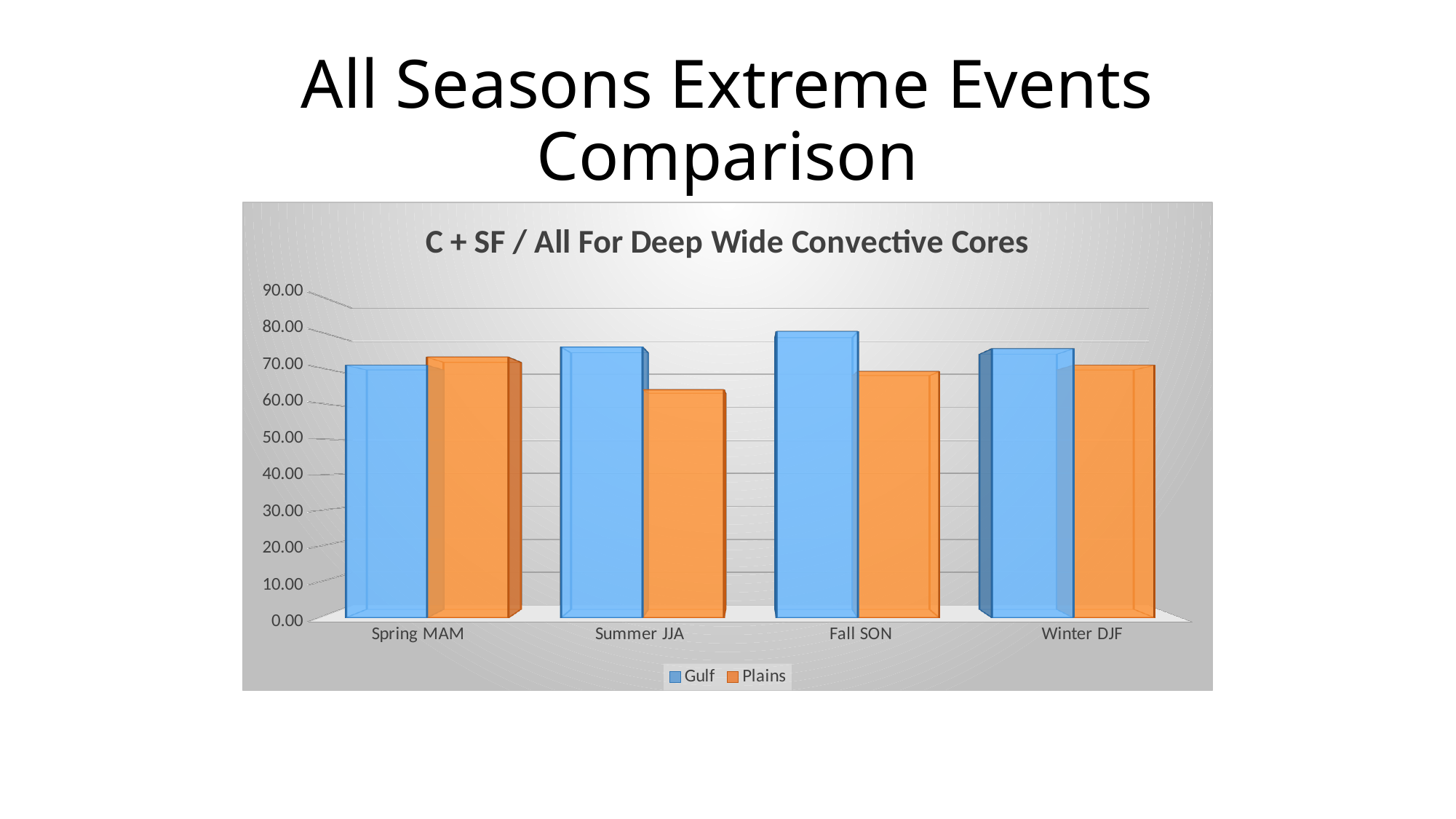
In Summer JJA, which is larger, the Gulf value or the Plains value? Gulf Is the Plains value for Summer JJA greater or less than 70.00? less What kind of chart is shown on the slide? Bar chart What is the title of the chart? C + SF / All For Deep Wide Convective Cores Which series is shown in orange? Plains Is the Gulf value for Spring MAM greater or less than 60.00? greater How many series does the legend list? 2 Is the Gulf value for Fall SON greater or less than 70.00? greater In Fall SON, which is larger, the Gulf value or the Plains value? Gulf How many seasons (categories) are shown on the x axis? 4 For which season is the Plains value lowest? Summer JJA For which season is the Gulf value highest? Fall SON